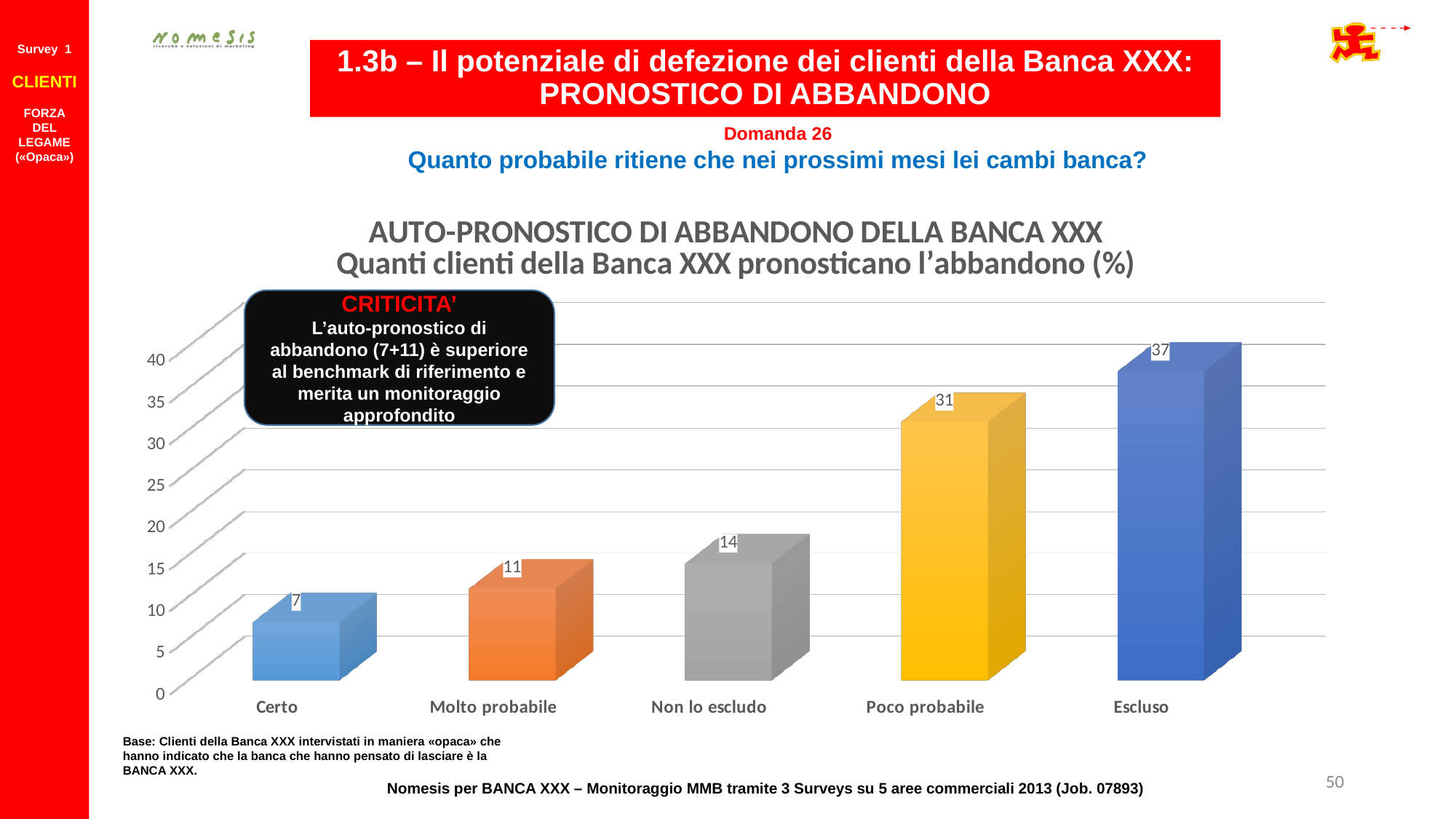
How many categories are shown on the x axis? 5 What is the value for "Molto probabile"? 11 What kind of chart is shown on the slide? Bar chart Which category has the highest value? Escluso Do the values rise or fall from left to right along the x axis? Rise What is the value for "Certo"? 7 What is the total of the values for "Certo" and "Molto probabile"? 18 What is the difference between the values for "Escluso" and "Poco probabile"? 6 Which category has the lowest value? Certo Which is larger, the value for "Non lo escludo" or the value for "Molto probabile"? Non lo escludo What is the value for "Poco probabile"? 31 What is the value for "Non lo escludo"? 14